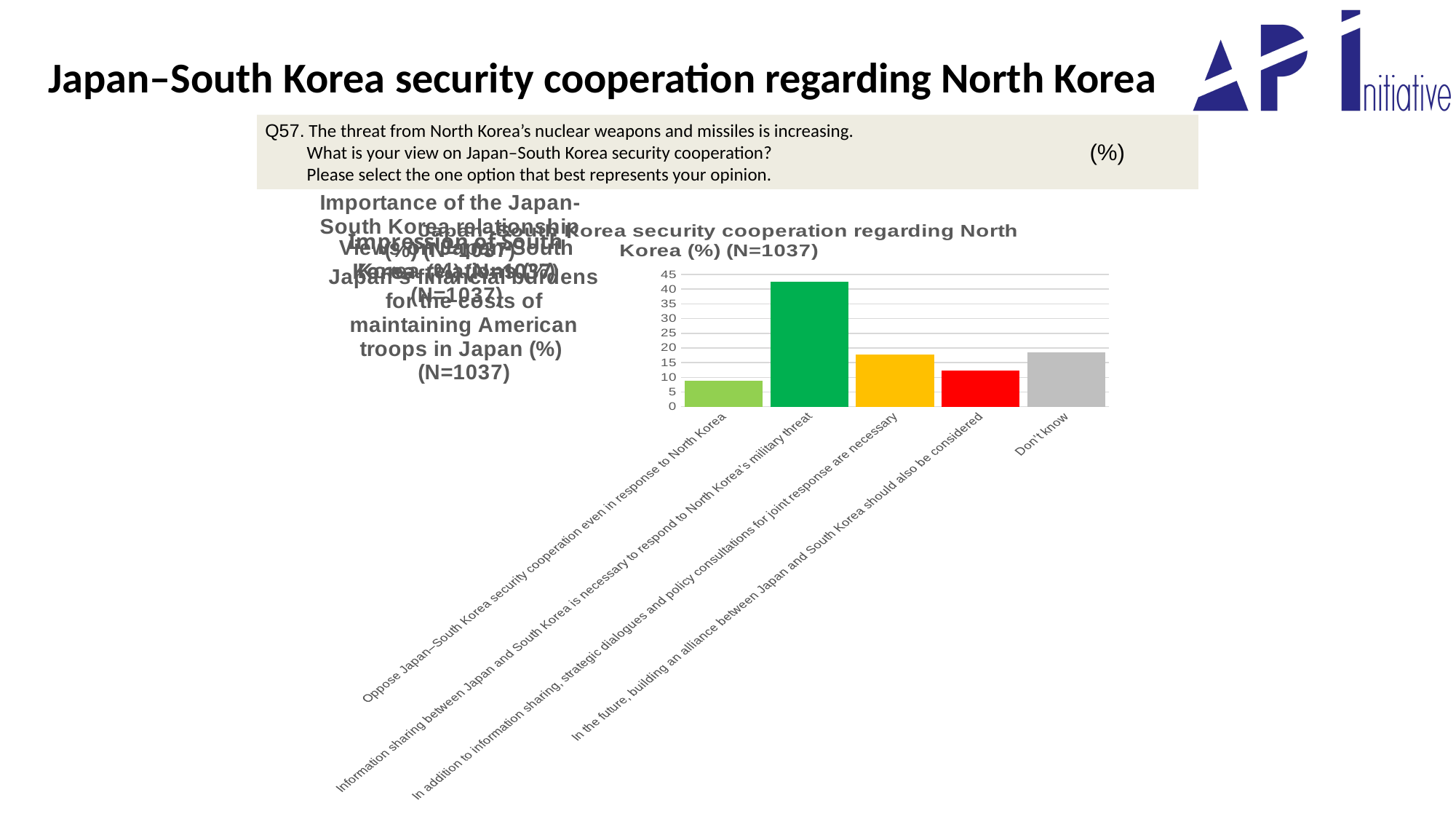
Which category has the lowest value? Oppose Japan–South Korea security cooperation even in response to North Korea Is the value for "In addition to information sharing, strategic dialogues and policy consultations for joint response are necessary" greater or less than 20? less How many categories are plotted in the chart? 5 What colour is the bar for "Don't know"? grey What kind of chart is shown on the slide? bar chart Which category has the highest value? Information sharing between Japan and South Korea is necessary to respond to North Korea's military threat Which is larger: the value for "In the future, building an alliance between Japan and South Korea should also be considered" or the value for "Oppose Japan–South Korea security cooperation even in response to North Korea"? In the future, building an alliance between Japan and South Korea should also be considered Is the value for "Don't know" greater or less than 15? greater Is the value for "In the future, building an alliance between Japan and South Korea should also be considered" greater or less than 10? greater Which is larger: the value for "Information sharing between Japan and South Korea is necessary to respond to North Korea's military threat" or the value for "Don't know"? Information sharing between Japan and South Korea is necessary to respond to North Korea's military threat